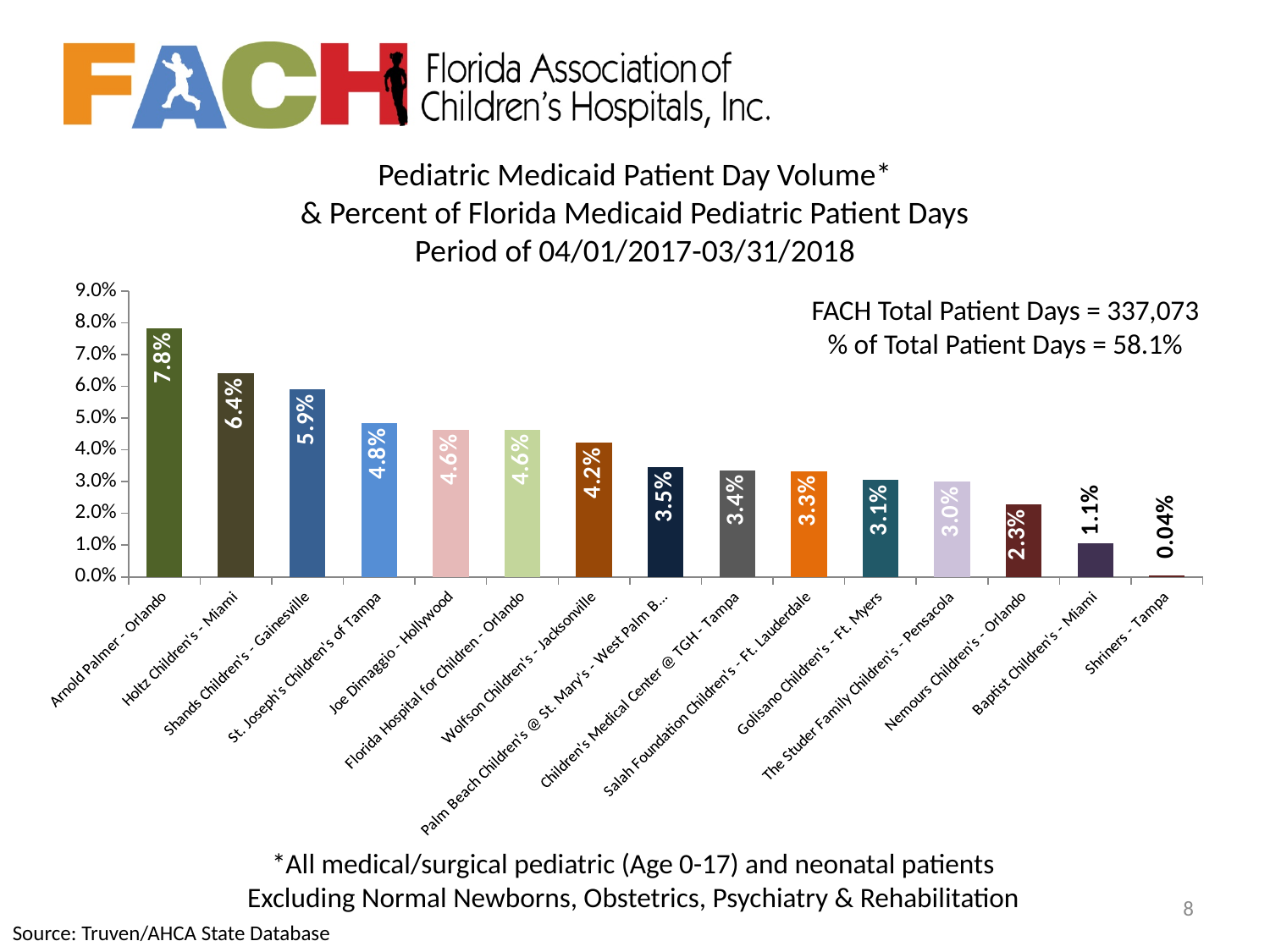
What kind of chart is shown on the slide? bar chart Do the values rise or fall from left to right along the x axis? fall What is the value for Wolfson Children's - Jacksonville? 4.2% Which is larger, the value for Wolfson Children's - Jacksonville or Golisano Children's - Ft. Myers? Wolfson Children's - Jacksonville Which hospital has the lowest percentage of Florida Medicaid pediatric patient days? Shriners - Tampa How many hospitals are shown in the chart? 15 Is the value for Shands Children's - Gainesville greater or less than 5.0%? greater What is the value for Shriners - Tampa? 0.04% Which hospital has the highest percentage of Florida Medicaid pediatric patient days? Arnold Palmer - Orlando What is the value for Arnold Palmer - Orlando? 7.8% What is the FACH Total Patient Days figure stated on the chart? 337,073 What is the difference between the values for Arnold Palmer - Orlando and Holtz Children's - Miami? 1.4%